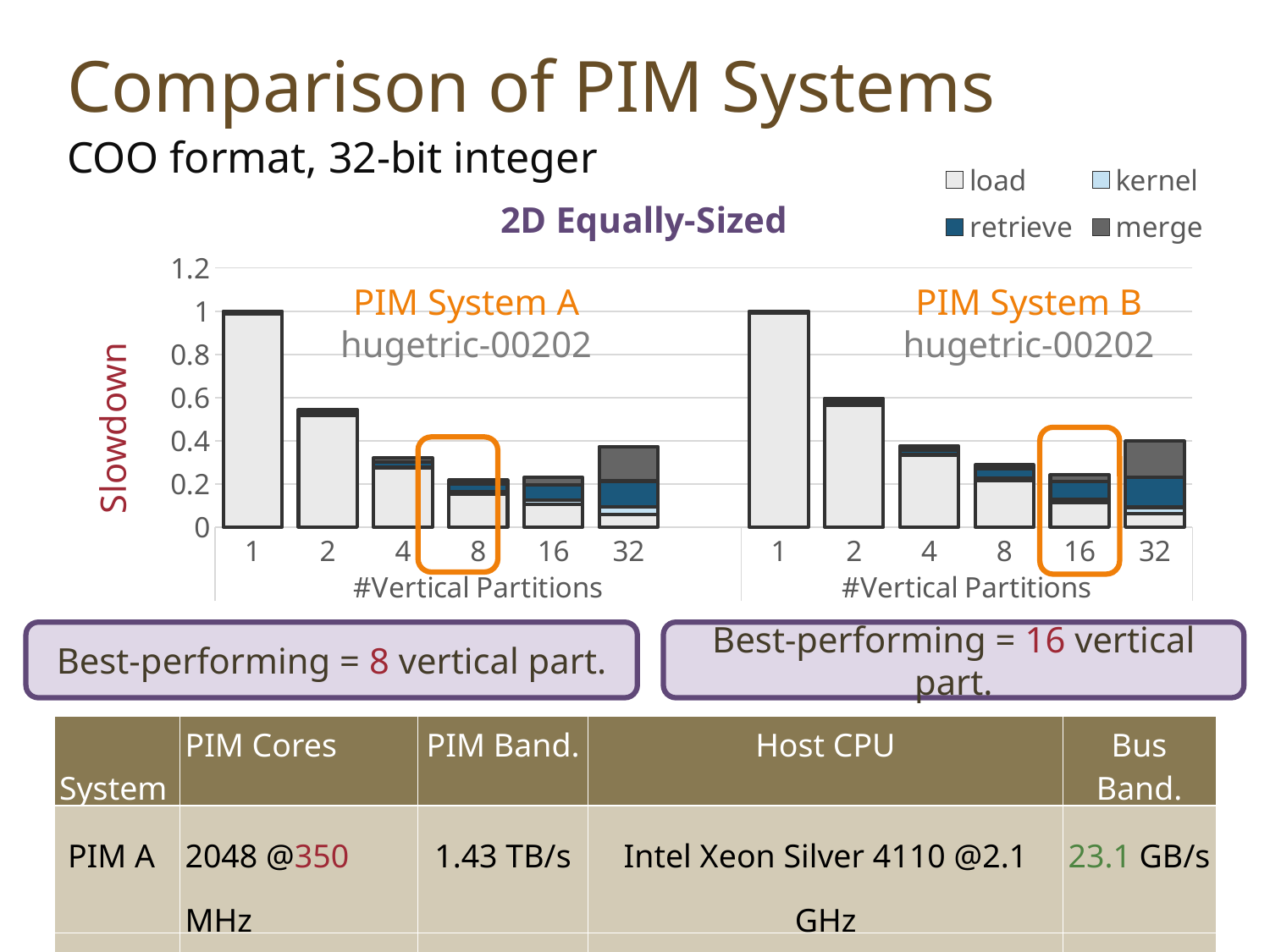
What is the label on the y axis of the charts? Slowdown In the PIM System A chart, is the slowdown for 2 vertical partitions greater or less than 0.4? greater In the PIM System A chart, what is the slowdown value for 1 vertical partition? 1 In the PIM System B chart, which number of vertical partitions has the lowest slowdown? 16 In the PIM System A chart, does the slowdown rise or fall from 1 to 8 vertical partitions? fall In the PIM System A chart, which number of vertical partitions has the highest slowdown? 1 In the PIM System B chart, is the slowdown for 32 vertical partitions greater or less than 0.2? greater In the PIM System A chart, which has the larger slowdown: 2 vertical partitions or 4 vertical partitions? 2 In the PIM System B chart, which has the larger slowdown: 1 vertical partition or 32 vertical partitions? 1 How many #Vertical Partitions categories are plotted in the PIM System B chart? 6 How many series does the legend list for the charts? 4 What kind of chart is used for PIM System A? Stacked bar chart